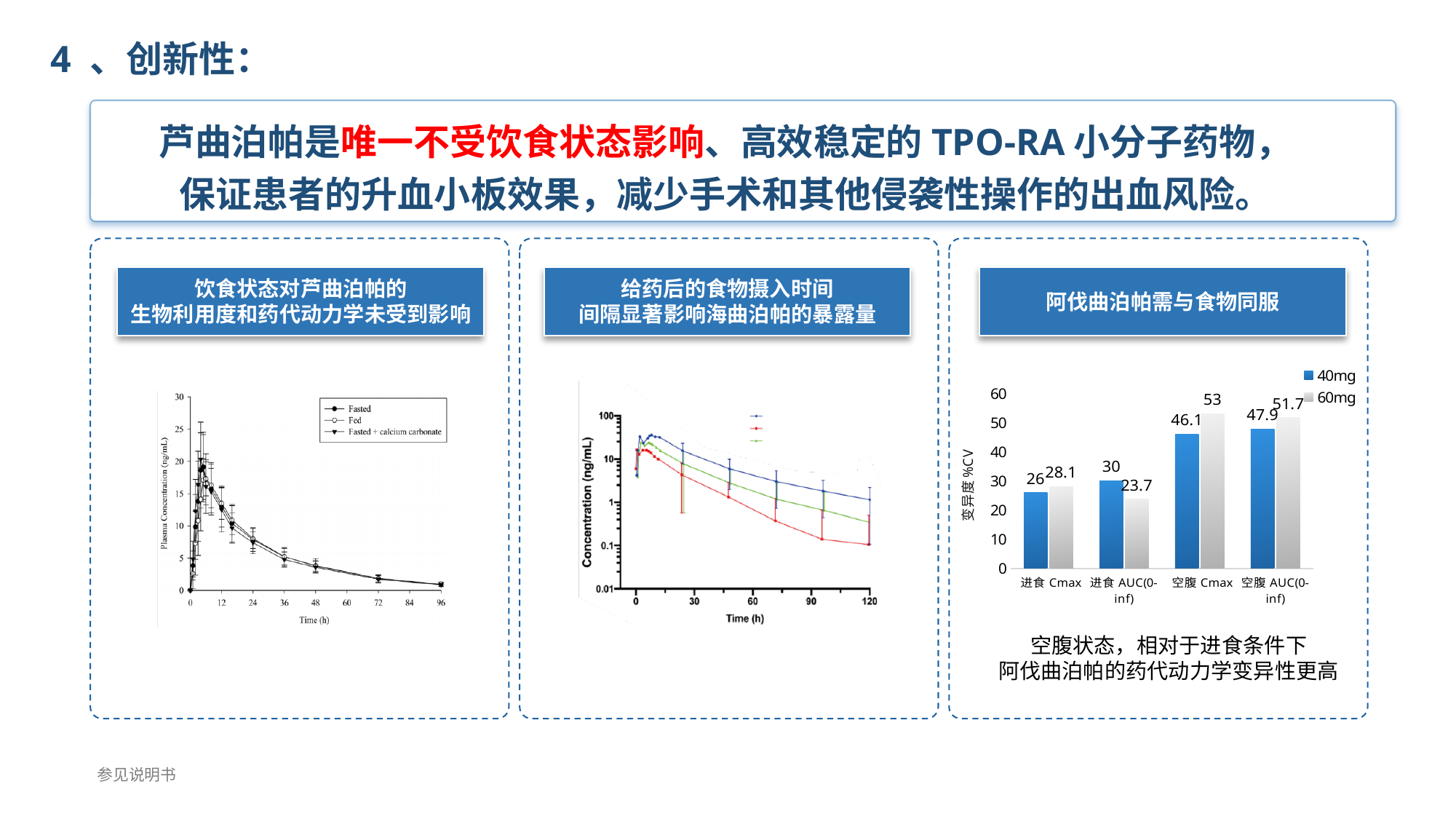
In the right bar chart (阿伐曲泊帕需与食物同服), what is the 40mg value for 空腹 Cmax? 46.1 In the left line chart (饮食状态对芦曲泊帕的生物利用度和药代动力学未受到影响), how many series does the legend list? 3 In the right bar chart (阿伐曲泊帕需与食物同服), for 进食 AUC(0-inf), which series has the larger value, 40mg or 60mg? 40mg In the right bar chart (阿伐曲泊帕需与食物同服), what is the difference between the 40mg values for 空腹 AUC(0-inf) and 进食 AUC(0-inf)? 17.9 What kind of chart is shown in the left panel titled 饮食状态对芦曲泊帕的生物利用度和药代动力学未受到影响? line chart What kind of chart is shown in the right panel titled 阿伐曲泊帕需与食物同服? bar chart In the right bar chart (阿伐曲泊帕需与食物同服), what is the 60mg value for 进食 AUC(0-inf)? 23.7 In the right bar chart (阿伐曲泊帕需与食物同服), which category has the highest 60mg value? 空腹 Cmax In the right bar chart (阿伐曲泊帕需与食物同服), which category has the lowest 40mg value? 进食 Cmax In the right bar chart (阿伐曲泊帕需与食物同服), how many series does the legend list? 2 In the right bar chart (阿伐曲泊帕需与食物同服), how many categories are shown on the x axis? 4 In the right bar chart (阿伐曲泊帕需与食物同服), what is the difference between the 60mg and 40mg values for 空腹 Cmax? 6.9